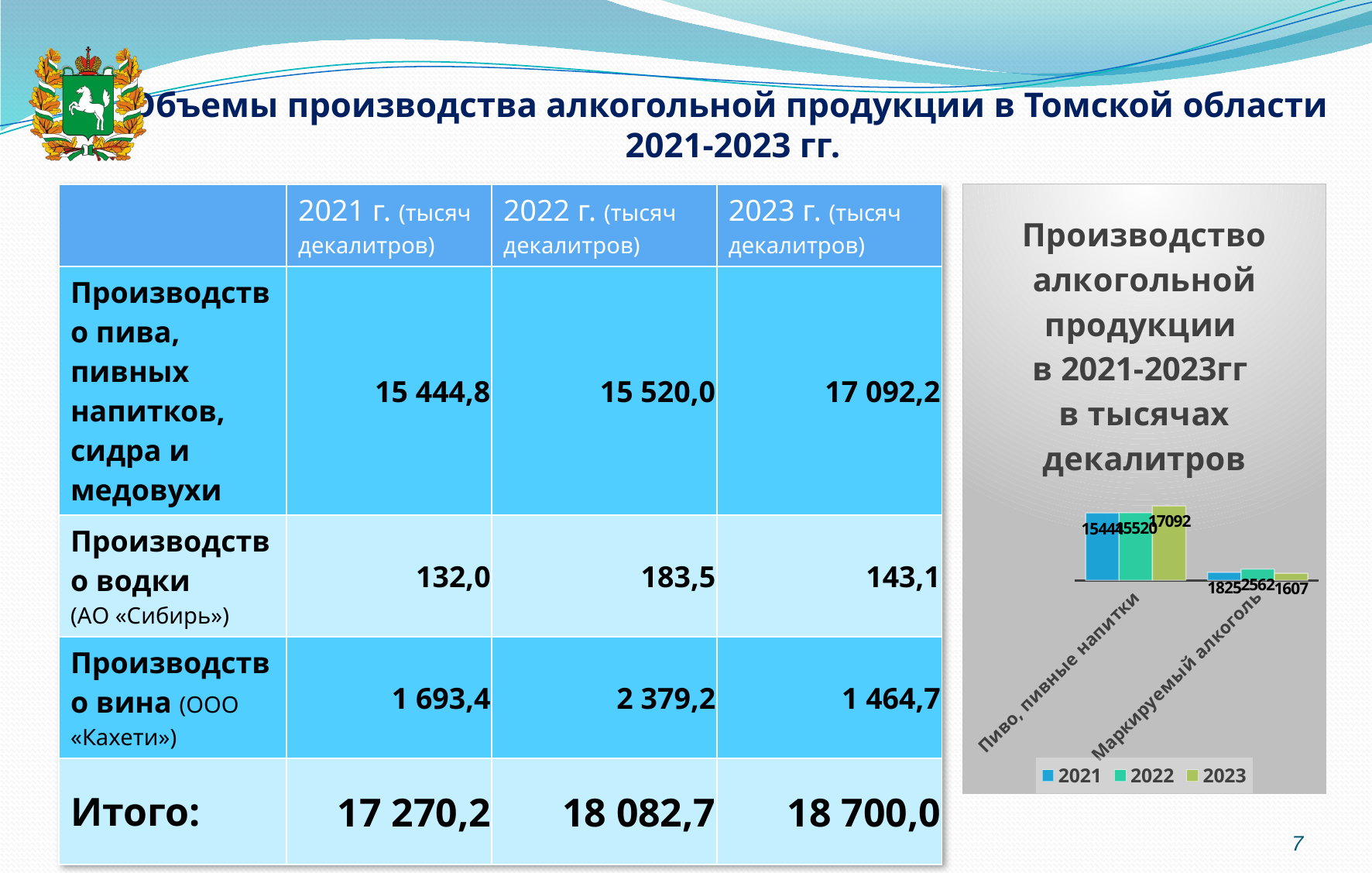
In the chart, which year has the lowest value for 'Маркируемый алкоголь'? 2023 In the chart, what is the difference between the 2023 and 2021 values for 'Пиво, пивные напитки'? 1648 In the chart, what is the value for 2021 in the category 'Пиво, пивные напитки'? 15444 What is the title of the chart on the slide? Производство алкогольной продукции в 2021-2023гг в тысячах декалитров In the chart, which is larger for 'Маркируемый алкоголь': the 2021 value or the 2023 value? 2021 In the chart, what is the value for 2023 in the category 'Пиво, пивные напитки'? 17092 How many categories are shown on the x axis of the chart? 2 How many series does the chart legend list? 3 In the chart, what is the value for 2021 in the category 'Маркируемый алкоголь'? 1825 In the chart, what is the value for 2022 in the category 'Маркируемый алкоголь'? 2562 In the chart, which year has the highest value for 'Маркируемый алкоголь'? 2022 What type of chart is shown on the right side of the slide? bar chart